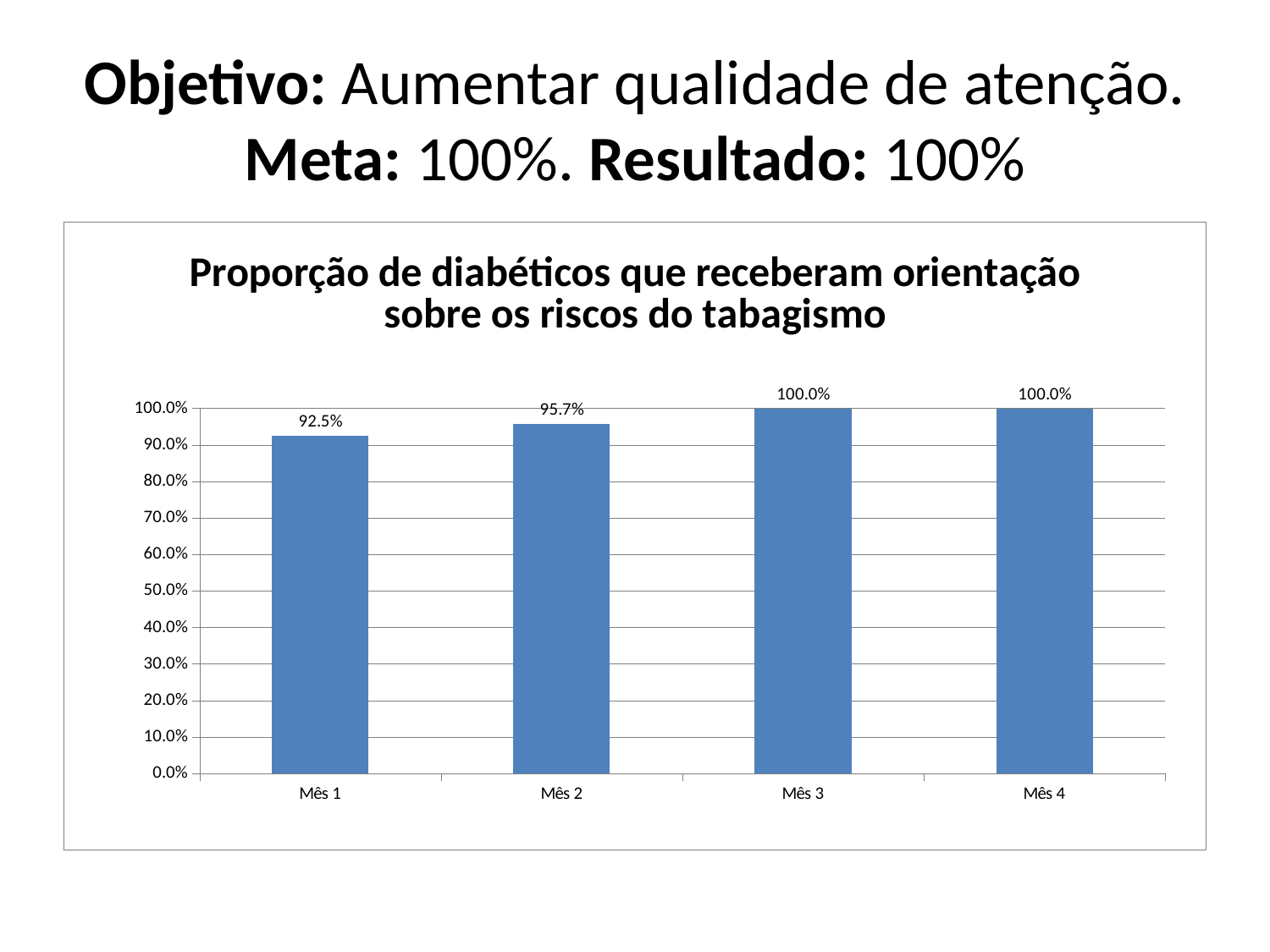
Which is larger, the value for Mês 1 or the value for Mês 2? Mês 2 Which month has the lowest value? Mês 1 What is the title of the chart? Proporção de diabéticos que receberam orientação sobre os riscos do tabagismo What kind of chart is shown on the slide? bar chart Do the values rise or fall from Mês 1 to Mês 3? rise What is the value for Mês 1? 92.5% How many months are shown on the x axis? 4 What is the difference between the values for Mês 3 and Mês 1? 7.5% What is the value for Mês 2? 95.7% Is the value for Mês 1 greater or less than 90.0%? greater What is the value for Mês 3? 100.0% What is the difference between the values for Mês 2 and Mês 1? 3.2%